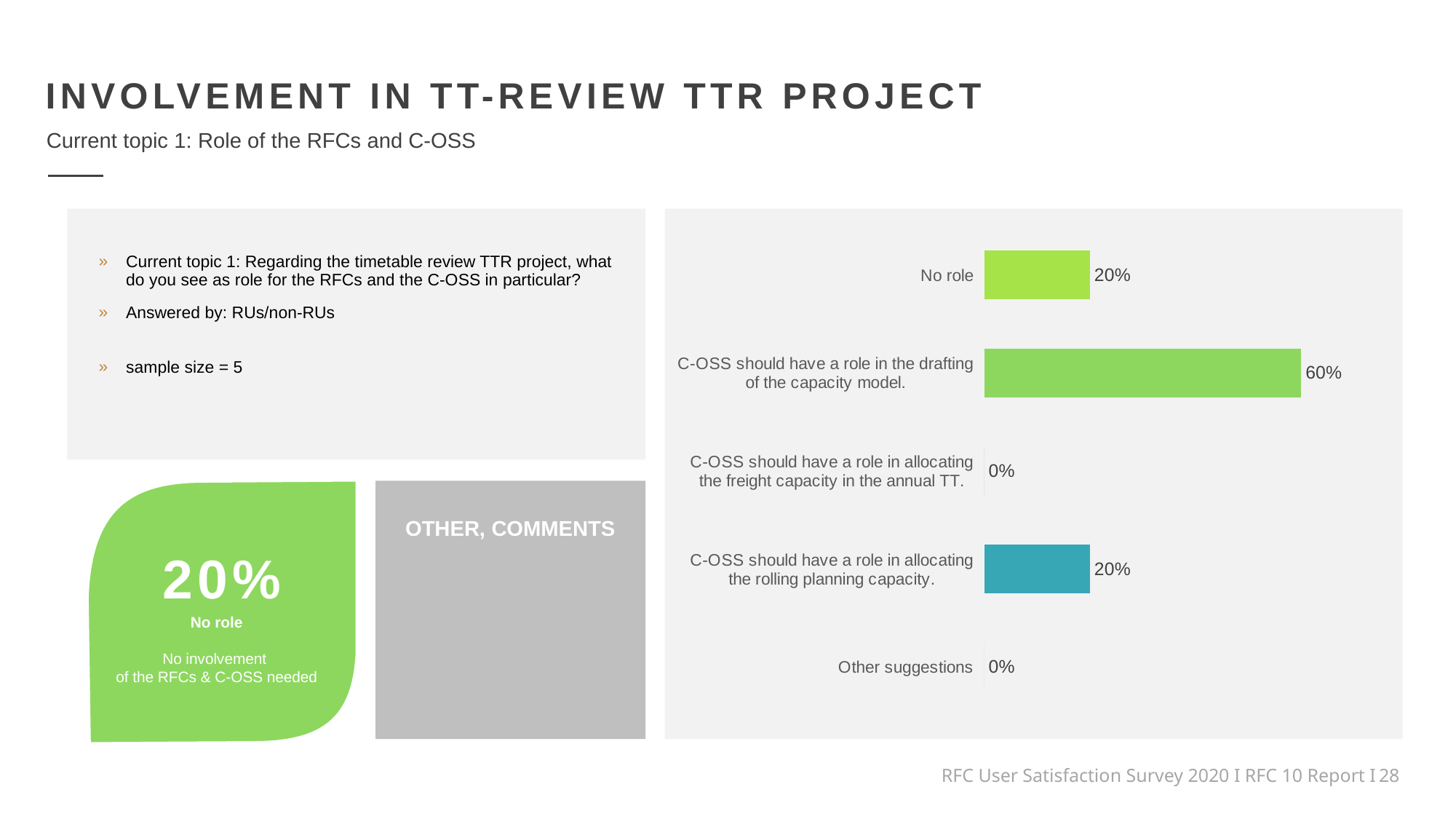
What percentage is shown for "C-OSS should have a role in allocating the freight capacity in the annual TT."? 0% What percentage is shown for "Other suggestions"? 0% How many categories in the chart have a value of 0%? 2 What is the difference between the percentage for "C-OSS should have a role in the drafting of the capacity model." and the percentage for "No role"? 40% What percentage is shown for "No role"? 20% How many categories are shown in the chart? 5 Which category has the highest percentage? C-OSS should have a role in the drafting of the capacity model. Which is larger: the percentage for "C-OSS should have a role in the drafting of the capacity model." or the percentage for "C-OSS should have a role in allocating the rolling planning capacity."? C-OSS should have a role in the drafting of the capacity model. What kind of chart is shown on the slide? Bar chart What colour is the bar for "C-OSS should have a role in allocating the rolling planning capacity."? Teal What percentage is shown for "C-OSS should have a role in the drafting of the capacity model."? 60% What percentage is shown for "C-OSS should have a role in allocating the rolling planning capacity."? 20%